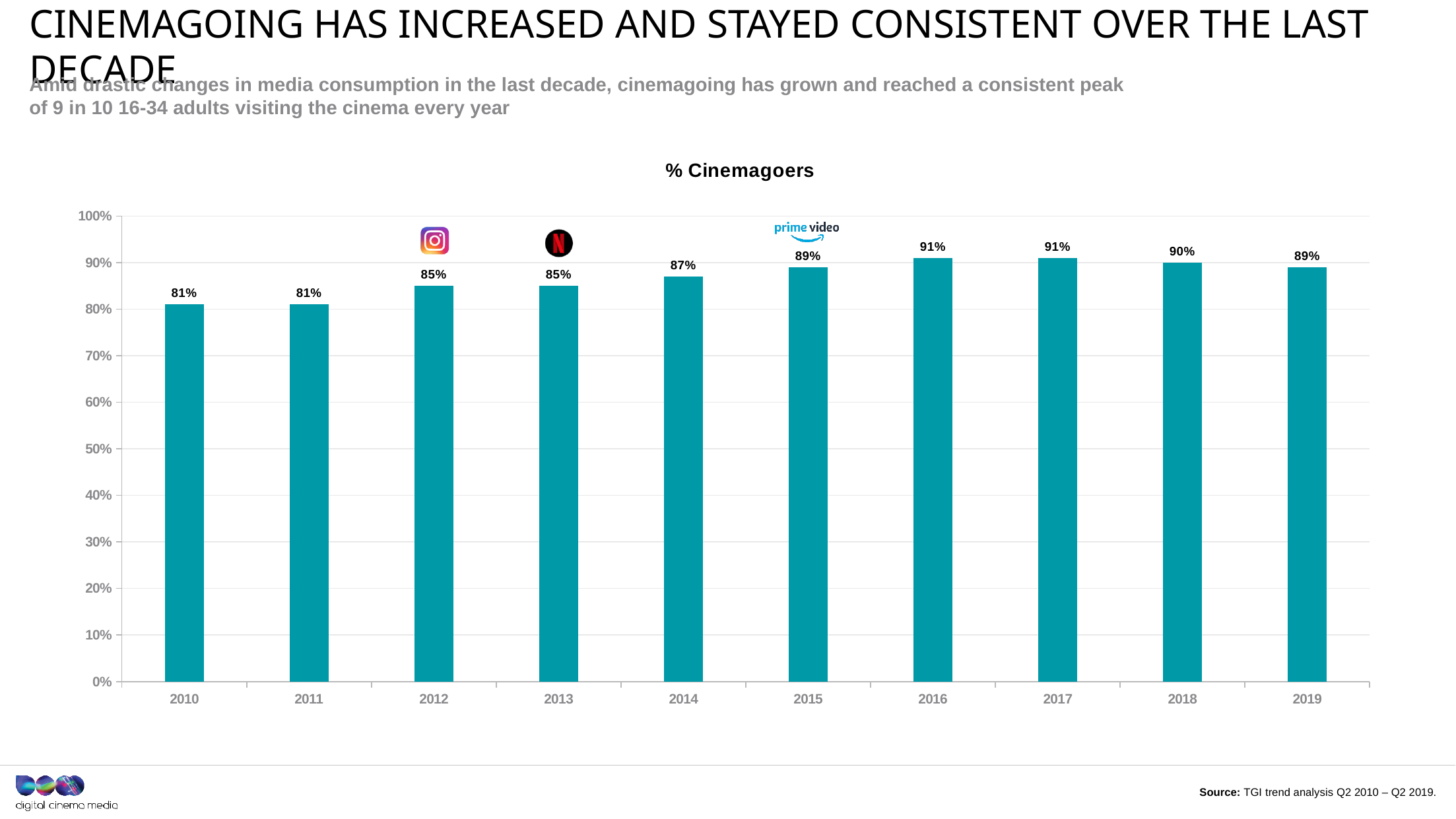
Do the values generally rise or fall from 2010 to 2017? Rise What is the value for 2014? 87% What is the value for 2010? 81% What is the value for 2018? 90% How many years are shown on the x axis? 10 Which is larger, the value for 2012 or the value for 2015? 2015 Which years have the highest value? 2016 and 2017 What is the value for 2019? 89% What is the difference between the values for 2017 and 2010? 10% Which years have the lowest value? 2010 and 2011 What is the title of the chart? % Cinemagoers What kind of chart is this? Bar chart